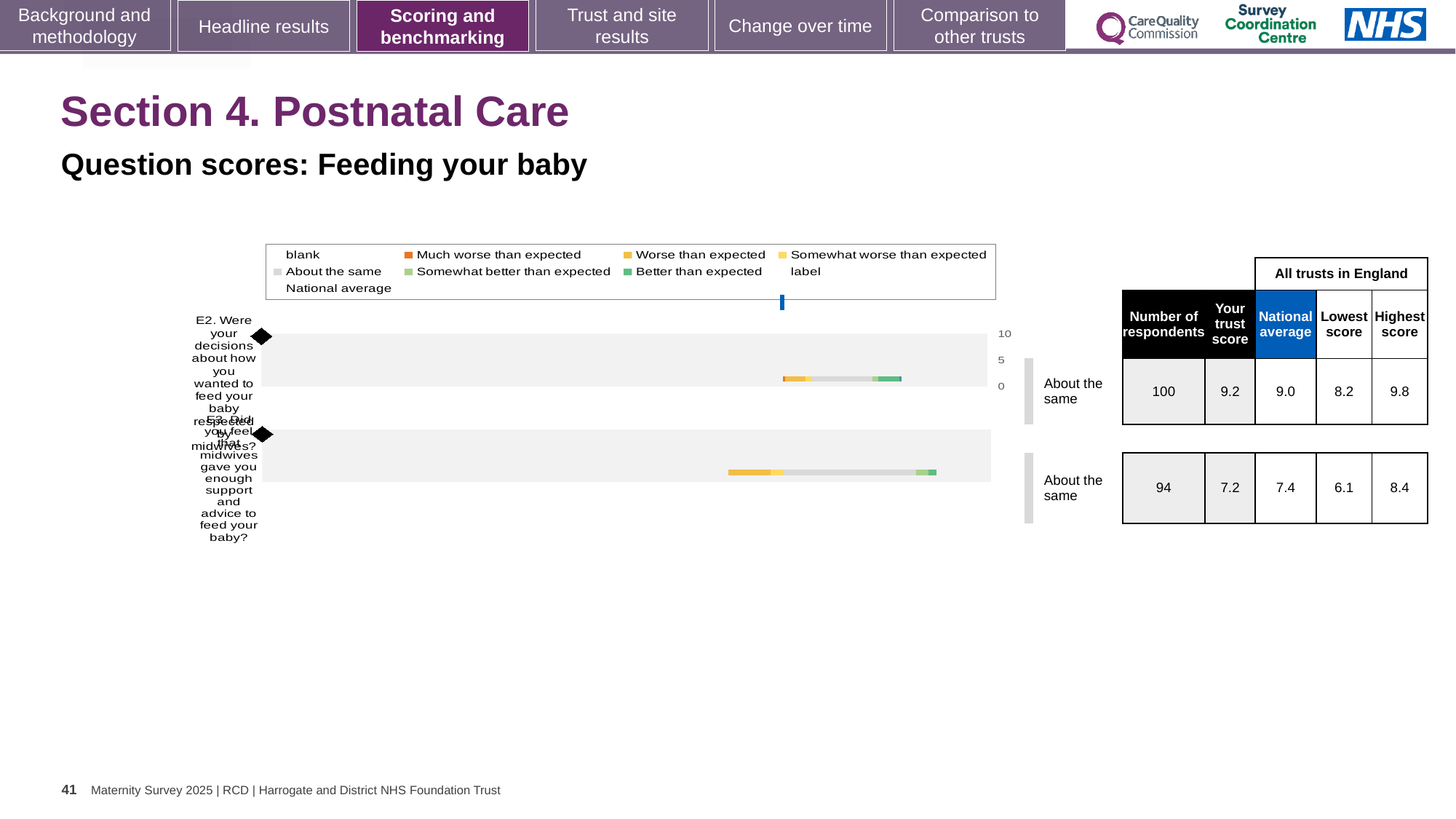
Which question has the higher trust score, E2 or E3? E2 For E2, which is larger: the trust score or the national average? Trust score (9.2) What is the trust score for E2 (decisions about how you wanted to feed your baby respected by midwives)? 9.2 What is the difference between the highest score and the lowest score for E2? 1.6 What benchmark category is shown for question E3? About the same How many respondents answered question E2? 100 How many respondents answered question E3? 94 What is the difference between the highest score and the lowest score for E3? 2.3 What is the national average for E3 (midwives gave you enough support and advice to feed your baby)? 7.4 What kind of chart is used to show the question scores for Feeding your baby? Bar chart For E3, which is larger: the trust score or the national average? National average (7.4) How many questions (categories) are plotted in the chart? 2